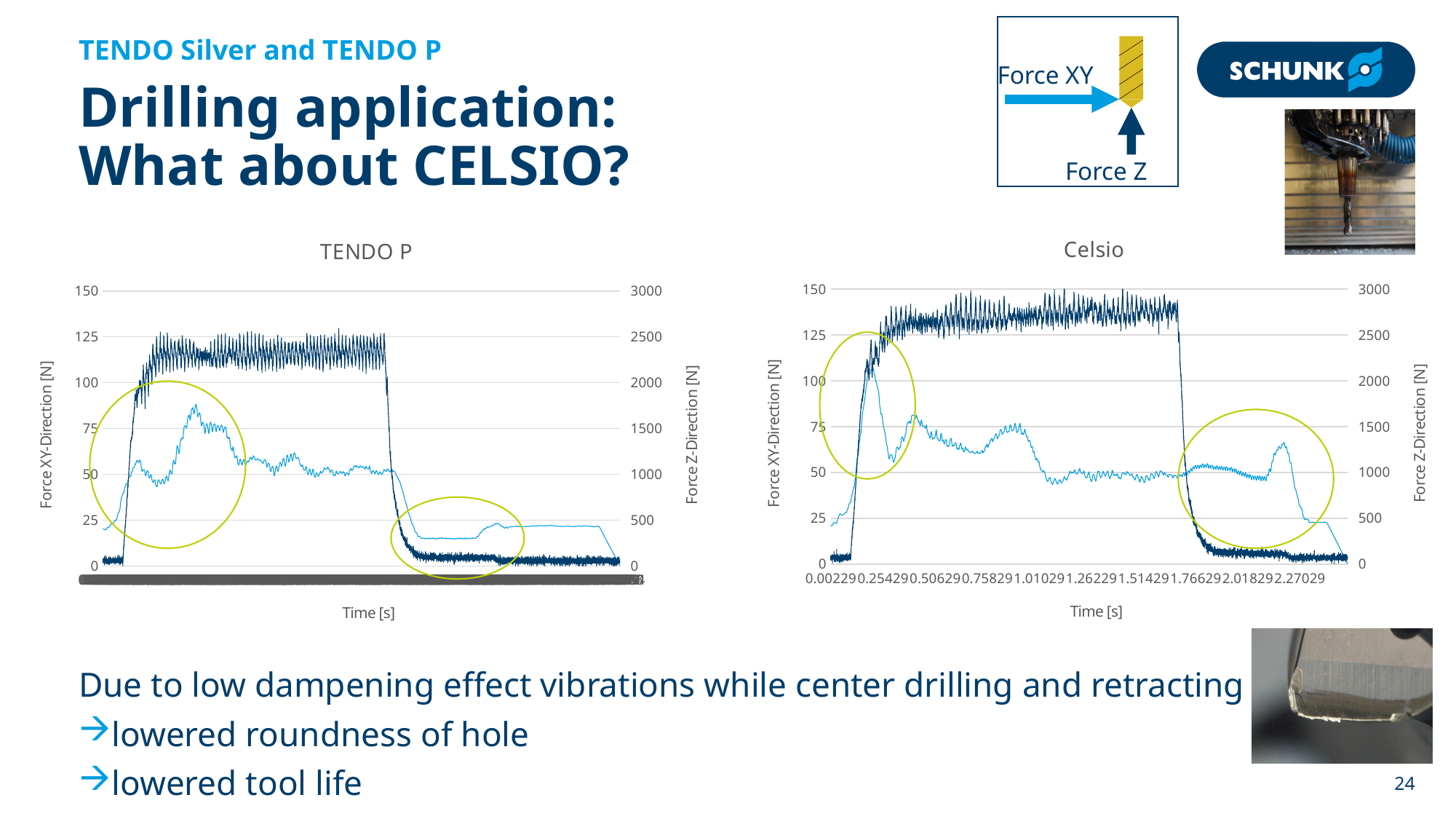
How many lines (series) are plotted in the Celsio chart? 2 In the TENDO P chart, is the plateau of the Force Z-Direction line (dark blue) greater or less than 2000 on the right axis? greater What is the left y-axis title of the TENDO P chart? Force XY-Direction [N] In the Celsio chart, is the Force XY-Direction peak (light blue) near the end of the drilling, inside the right circle, greater or less than 50 on the left axis? greater In the Celsio chart, is the plateau of the Force Z-Direction line (dark blue) greater or less than 2500 on the right axis? greater How many charts are shown on the slide? 2 In the Celsio chart, what is the maximum value shown on the left y-axis (Force XY-Direction)? 150 What is the x-axis title of the Celsio chart? Time [s] In the TENDO P chart, what is the maximum value shown on the right y-axis (Force Z-Direction)? 3000 What kind of chart is the TENDO P chart? line chart